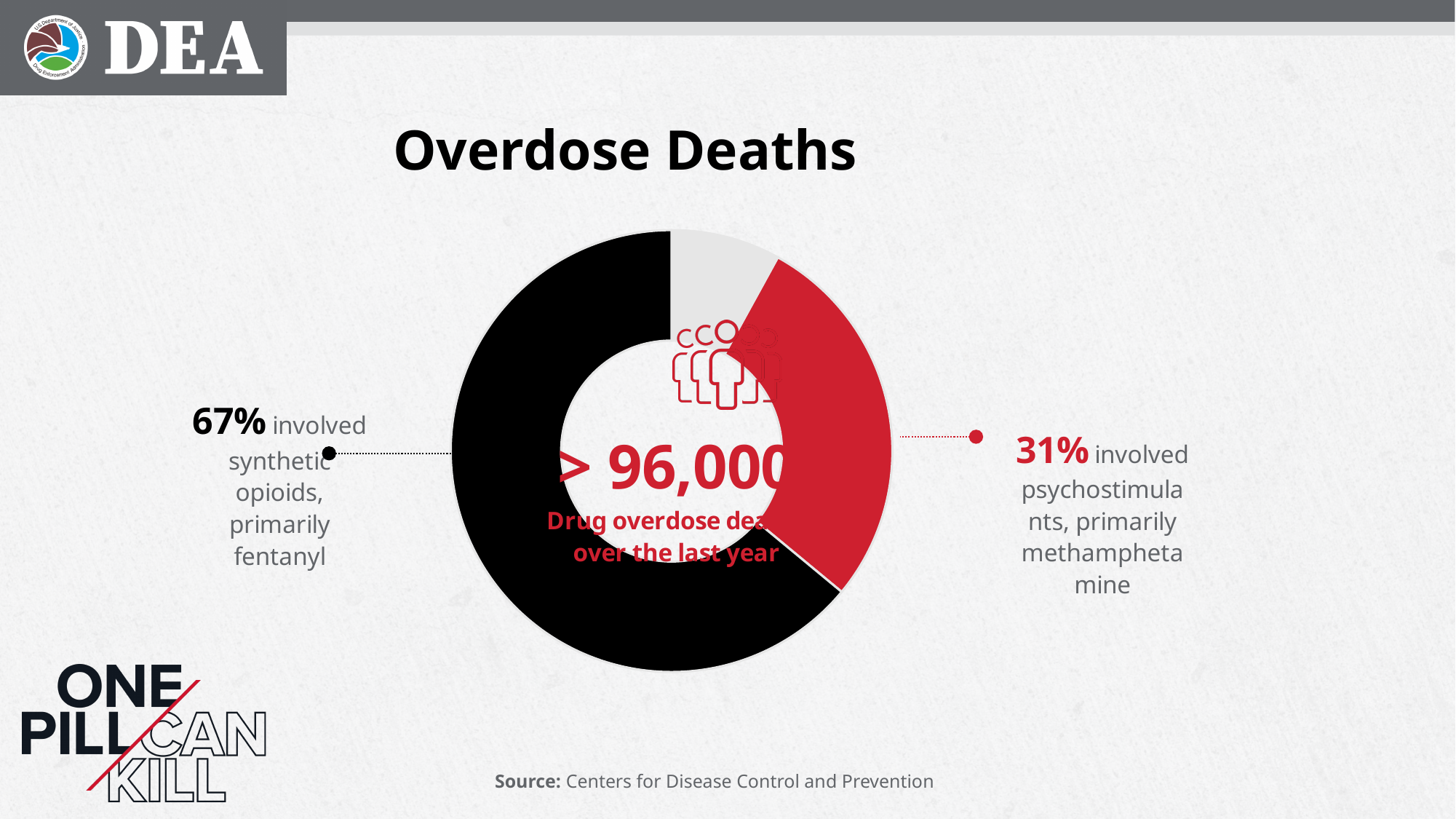
What percentage of overdose deaths involved synthetic opioids, primarily fentanyl? 67% What kind of chart is shown on the slide? Pie (donut) chart What colour is the segment representing synthetic opioids, primarily fentanyl? Black How many segments does the donut chart have? 3 What is the title of the chart? Overdose Deaths Which is larger: the share for synthetic opioids or the share for psychostimulants? Synthetic opioids Which labeled category accounts for the largest share of the chart? Synthetic opioids, primarily fentanyl By how many percentage points does the synthetic opioids share exceed the psychostimulants share? 36 percentage points What percentage of overdose deaths involved psychostimulants, primarily methamphetamine? 31% Is the share for synthetic opioids greater or less than 50%? greater What number is shown in the center of the donut chart? > 96,000 Is the share for psychostimulants greater or less than 50%? less